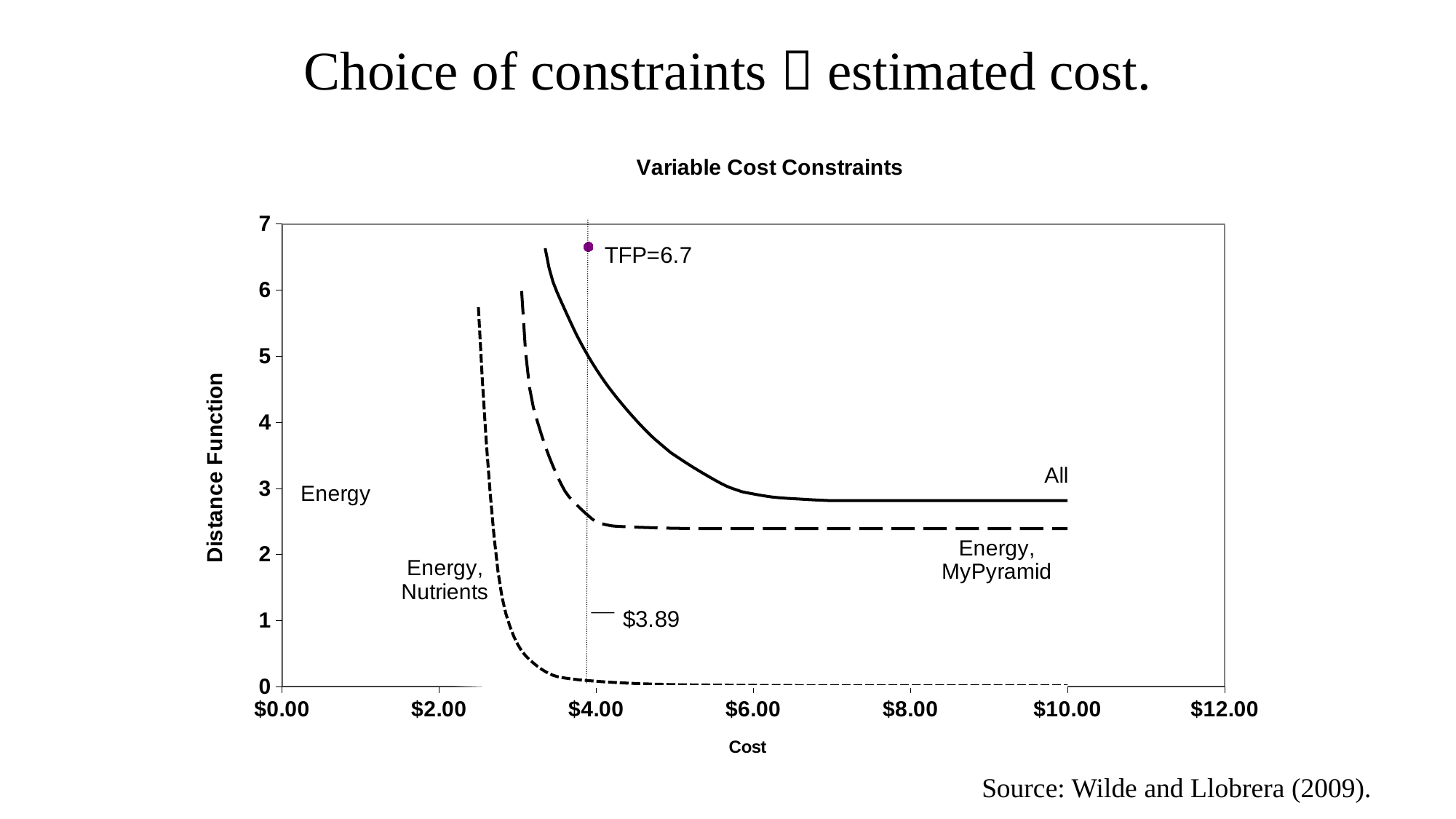
At a cost of $4.00, which curve is higher: All or Energy, MyPyramid? All Is the value of the Energy, Nutrients curve at a cost of $8.00 greater or less than 1? less What is the highest value shown on the vertical axis of the chart? 7 Is the value of the All curve at a cost of $10.00 greater or less than 3? less What is the title of the chart? Variable Cost Constraints Which curve has the lowest distance function at a cost of $6.00? Energy, Nutrients Which curve has the highest distance function at a cost of $6.00? All What kind of chart is shown on the slide? line chart What is the label of the vertical axis of the chart? Distance Function As cost increases along the x axis, does the distance function for each curve rise or fall? fall What cost value is marked by the vertical dotted line on the chart? $3.89 What TFP value is marked by the point on the chart? TFP=6.7